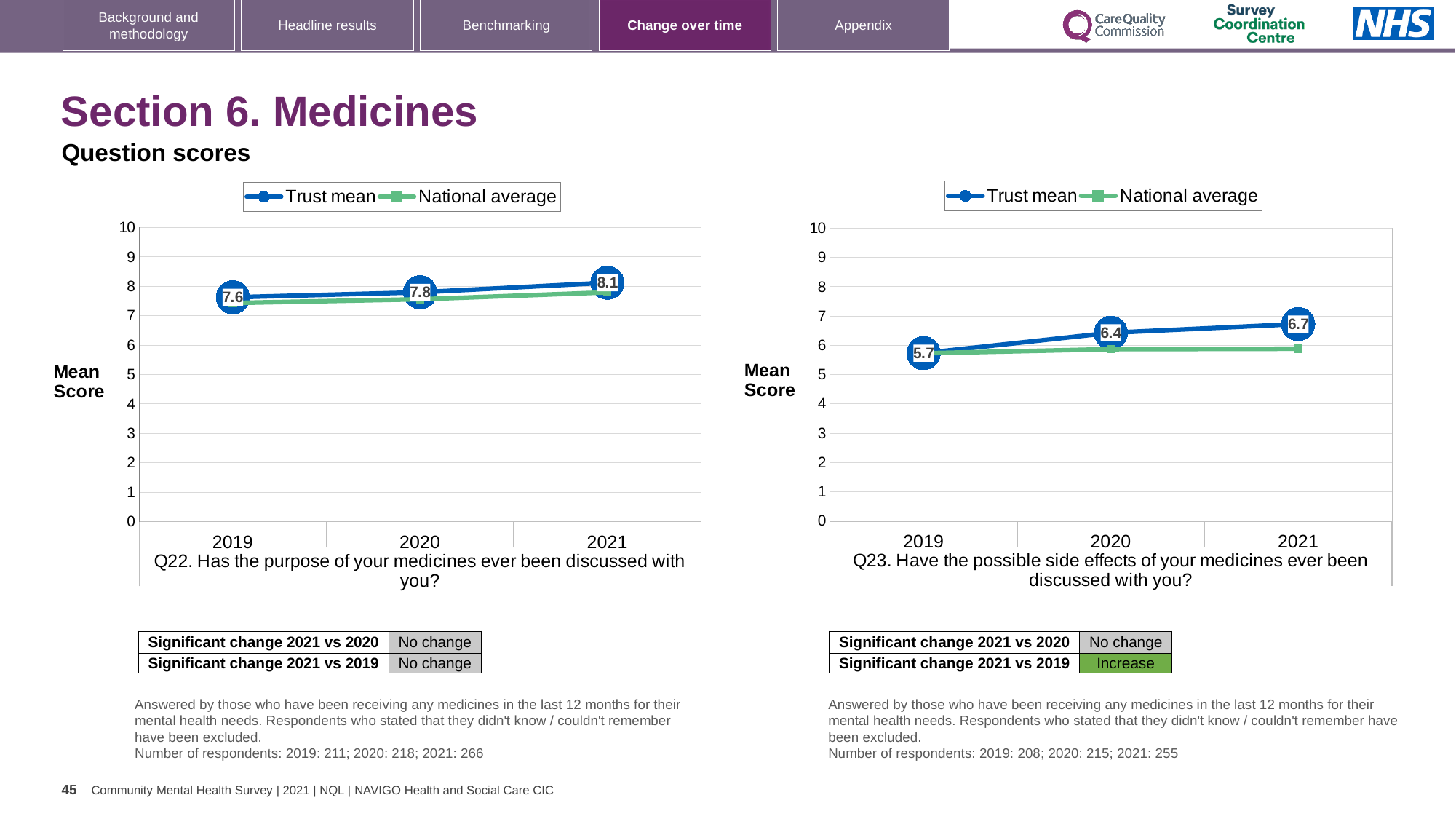
In the Q22 chart, which year has the lowest Trust mean score? 2019 In the Q23 chart, what is the Trust mean score for 2019? 5.7 In the Q22 chart, what is the Trust mean score for 2021? 8.1 In the Q22 chart, what is the difference between the Trust mean scores for 2021 and 2019? 0.5 How many series does the legend of the Q22 chart list? 2 In the Q22 chart, is the National average for 2019 greater or less than 7? greater In the Q23 chart, which year has the highest Trust mean score? 2021 In the Q23 chart, what is the difference between the Trust mean scores for 2020 and 2019? 0.7 In the Q23 chart, what is the Trust mean score for 2020? 6.4 In the Q23 chart, which is larger in 2021, the Trust mean or the National average? Trust mean What type of chart is the Q23 chart? line chart In the Q23 chart, does the Trust mean rise or fall from 2019 to 2021? rise